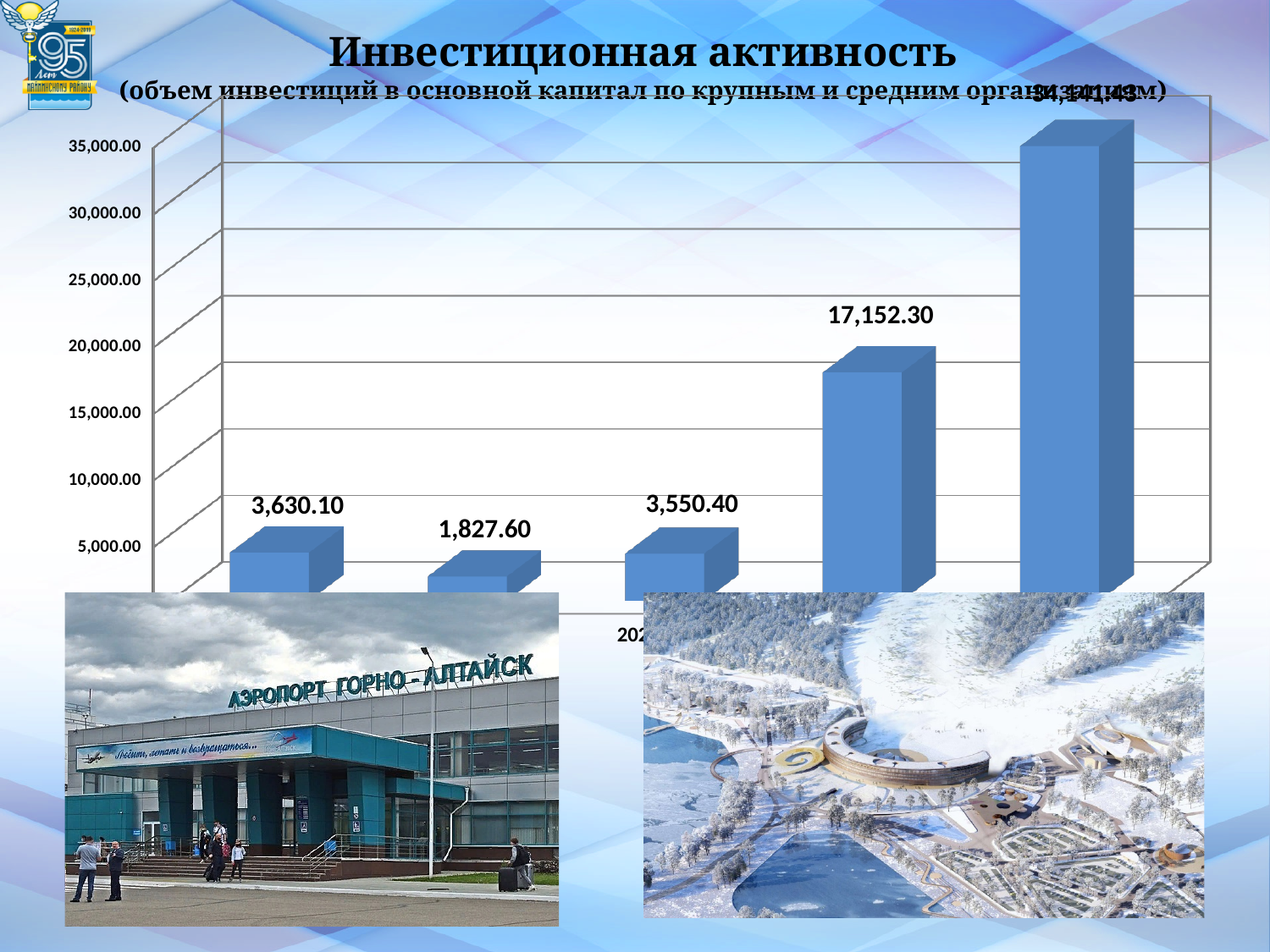
What is the title of the chart? Инвестиционная активность How many bars are plotted in the chart? 5 Is the value of the rightmost bar greater or less than 30,000.00? greater What is the value shown on the fourth bar from the left? 17,152.30 What is the value shown on the first (leftmost) bar? 3,630.10 What is the value shown on the third bar from the left? 3,550.40 What is the value shown on the second bar from the left? 1,827.60 Which bar has the highest value? the fifth (rightmost) bar Which bar has the lowest value? the second bar (1,827.60) Which is larger, the value of the first bar or the value of the third bar? the first bar (3,630.10) What is the difference between the fourth bar (17,152.30) and the first bar (3,630.10)? 13,522.20 What kind of chart is shown on the slide? bar chart